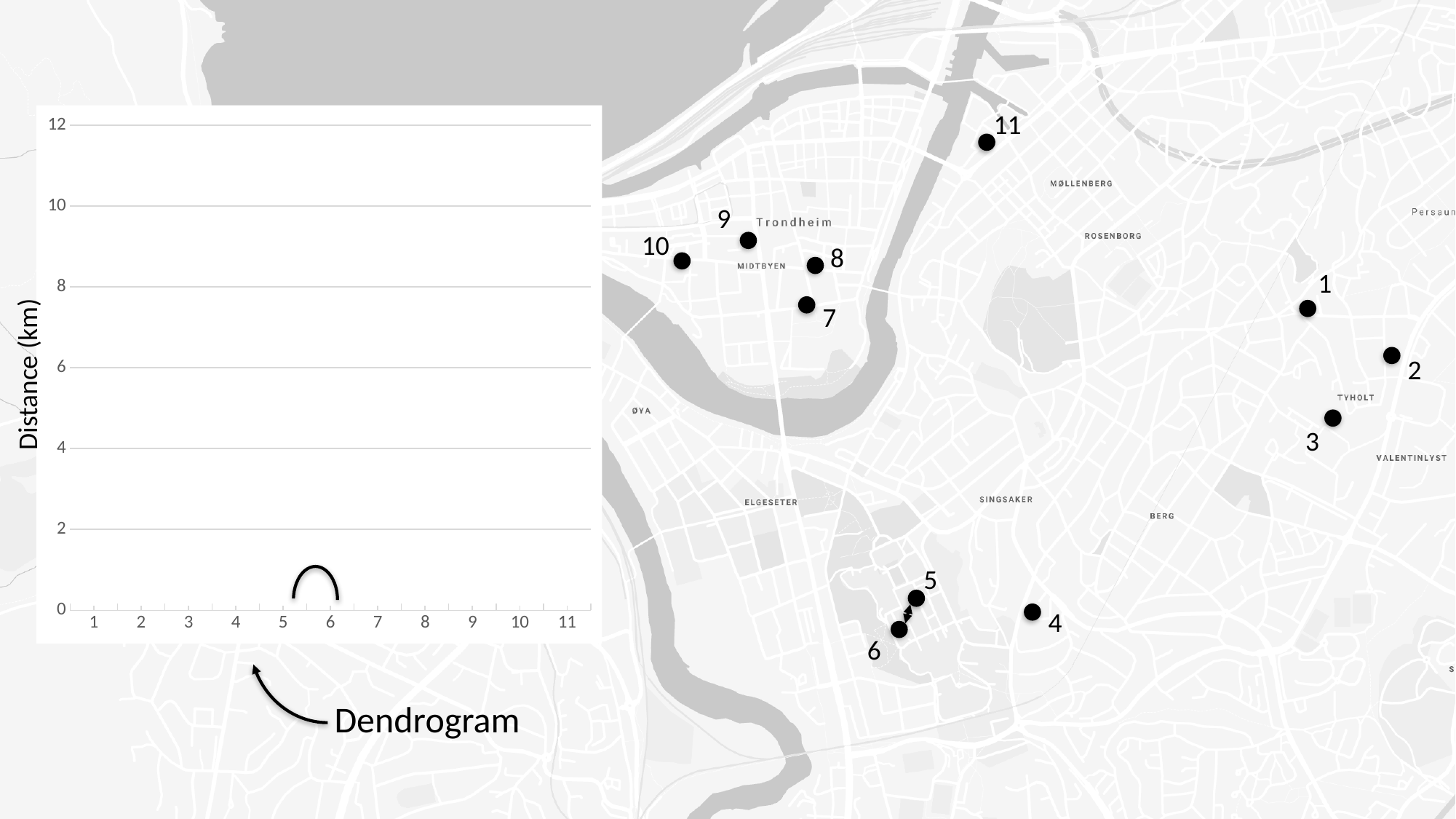
What is the highest value shown on the vertical axis of the dendrogram? 12 What is the label of the vertical axis of the dendrogram? Distance (km) What is the lowest value shown on the vertical axis of the dendrogram? 0 How many numbered points are plotted on the map? 11 How many categories are listed along the x axis of the dendrogram? 11 Which two numbered points on the map are connected by a double-headed arrow? 5 and 6 Is the height of the link joining categories 5 and 6 in the dendrogram greater or less than 2 km? less What kind of chart is shown on the left of the slide? Dendrogram What is the interval between consecutive tick labels on the vertical axis of the dendrogram? 2 Which two categories are joined by the only link drawn in the dendrogram? 5 and 6